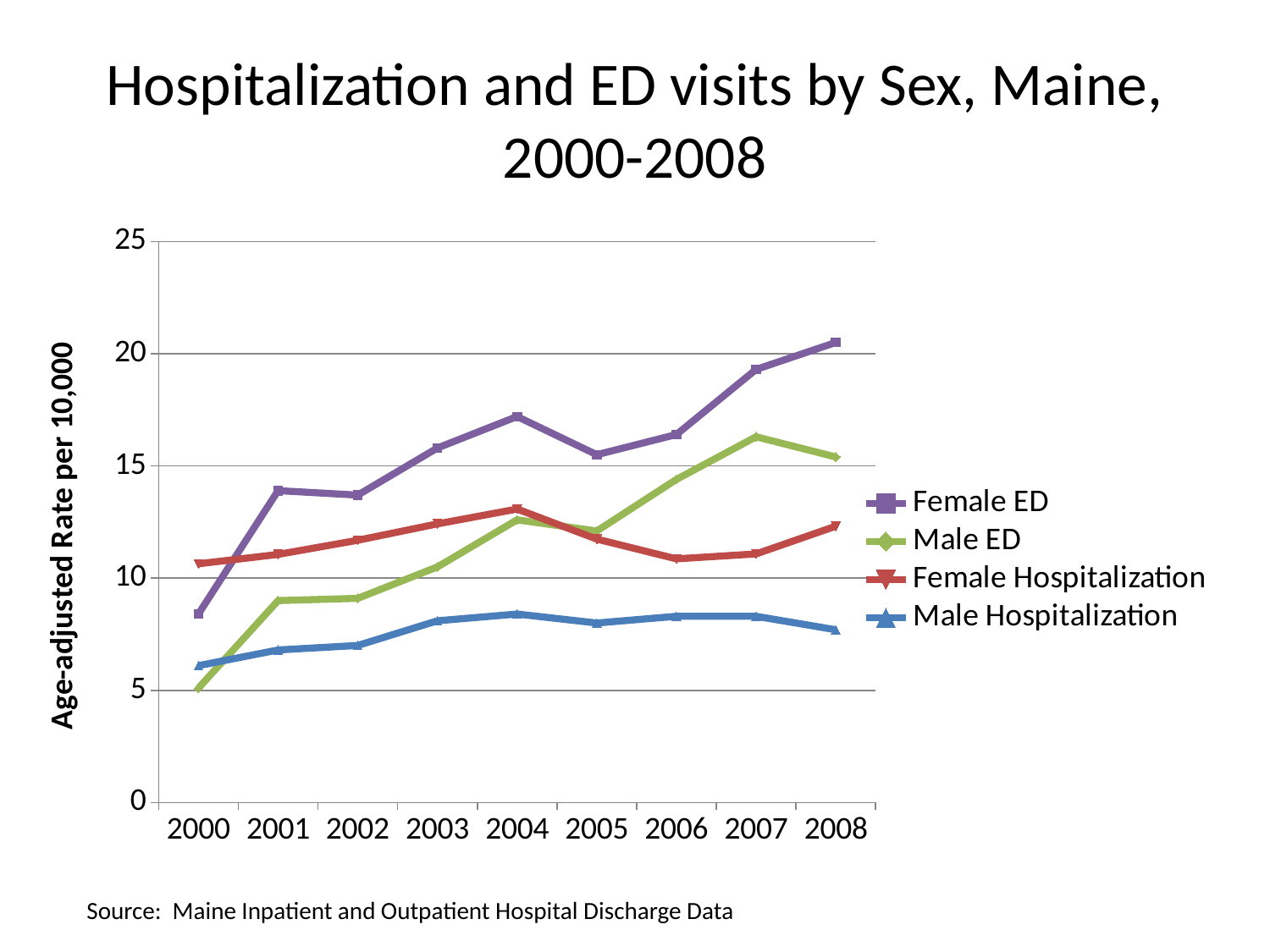
How many years are plotted along the x axis? 9 What kind of chart is shown on the slide? line chart Which series has the lowest value in 2008? Male Hospitalization In 2000, which is larger: Female Hospitalization or Female ED? Female Hospitalization How many series does the legend list? 4 Which series has the highest value in 2008? Female ED Is the value for Female Hospitalization in 2004 greater or less than 15? less In which year does Female ED reach its highest value? 2008 Is the value for Female ED in 2007 greater or less than 20? less Is the value for Male ED in 2007 greater or less than 15? greater What is the title of the y axis? Age-adjusted Rate per 10,000